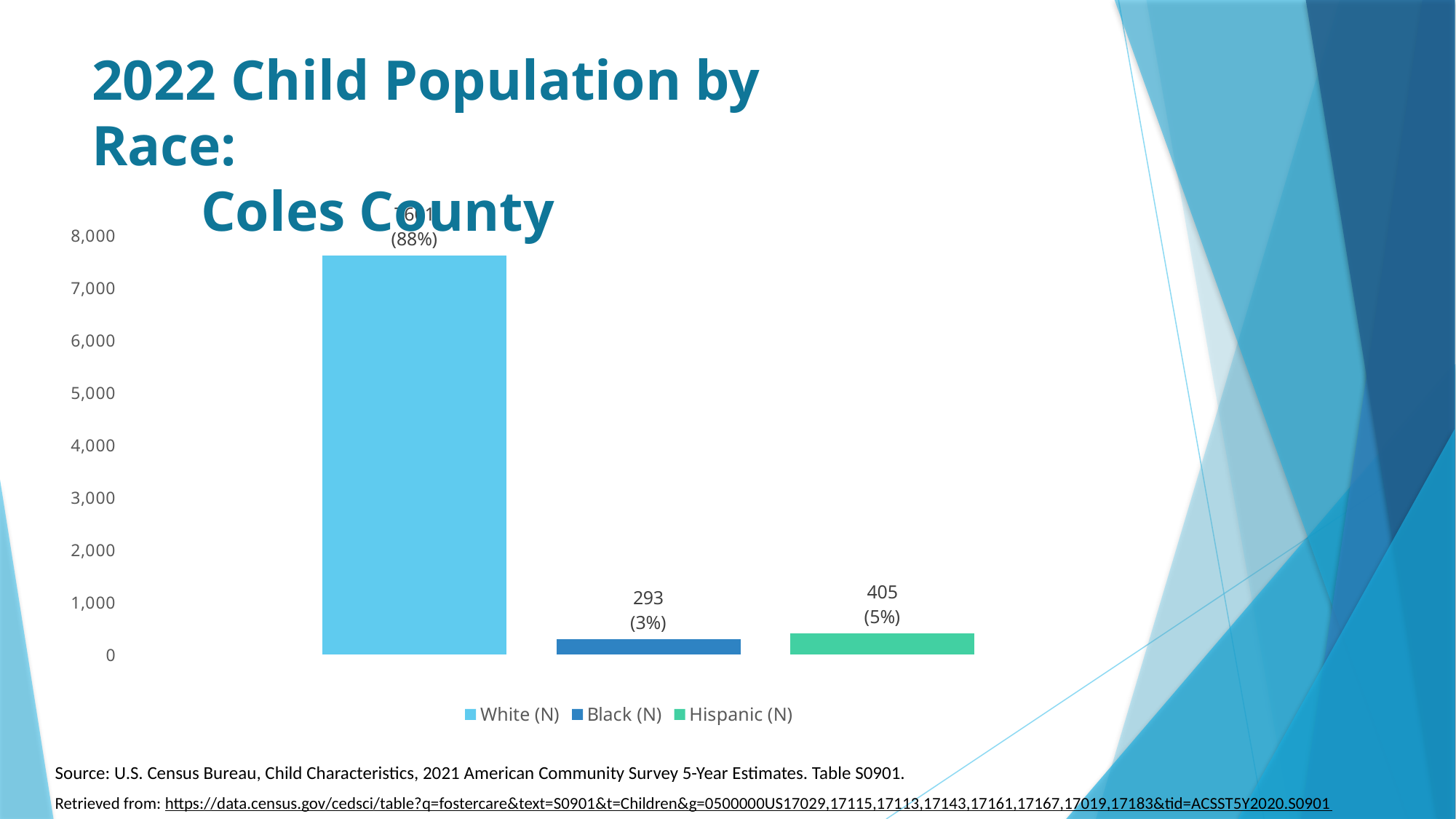
How many series does the legend list? 3 Is the value for White (N) greater or less than 7,000? greater What is the difference between the Hispanic (N) and Black (N) values? 112 Which is larger, the value for Hispanic (N) or Black (N)? Hispanic (N) What kind of chart is shown on the slide? bar chart What is the value shown for Black (N)? 293 Which group has the highest child population? White (N) What percentage is shown for Black (N)? 3% What percentage is shown for Hispanic (N)? 5% What is the value shown for Hispanic (N)? 405 Which group has the lowest child population? Black (N) What percentage is shown for White (N)? 88%